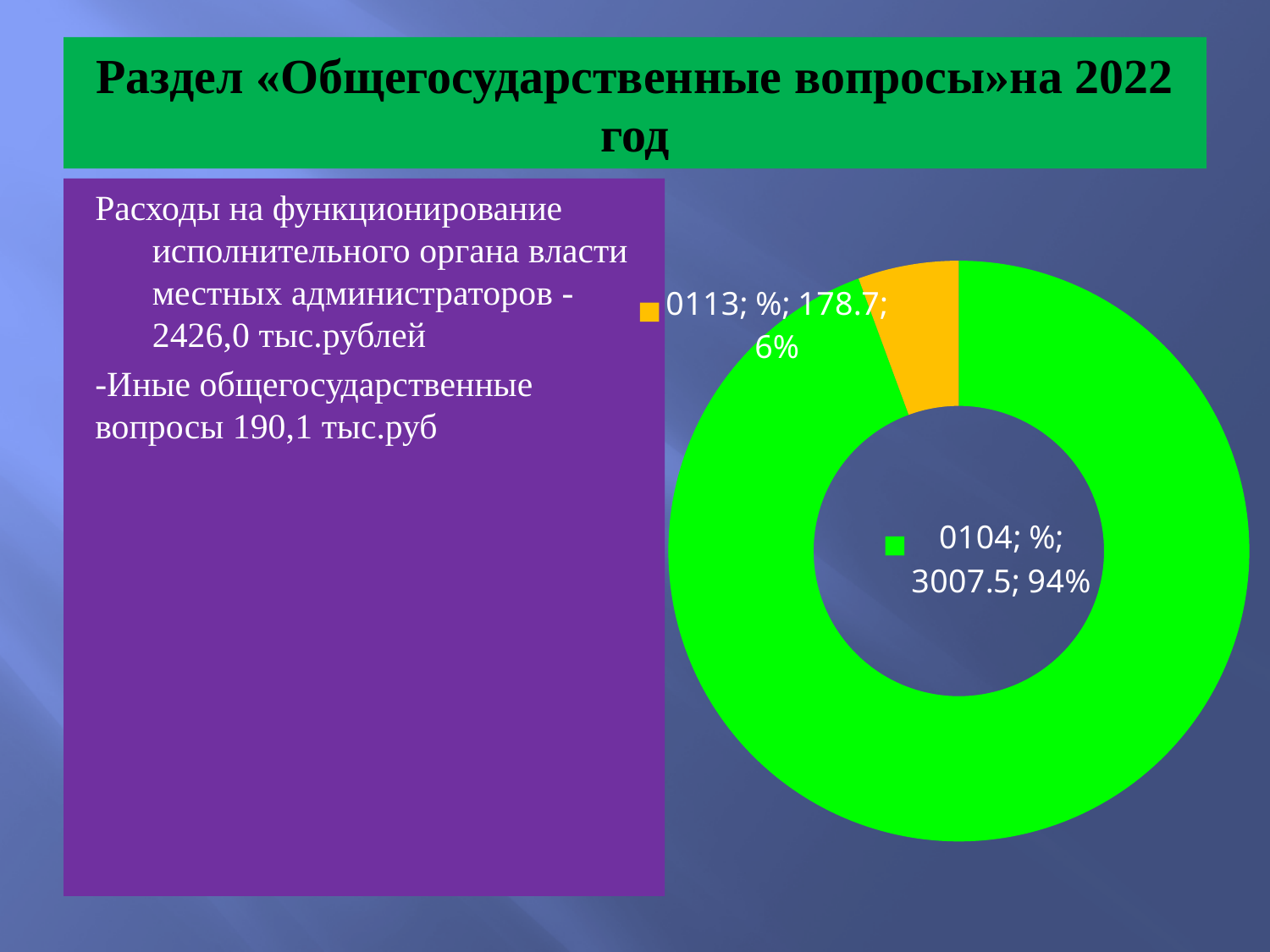
Which category has the smallest slice? 0113 What share of the doughnut does category 0104 represent? 94% What colour is the slice for category 0113? orange What colour is the slice for category 0104? green What kind of chart is shown on the slide? doughnut (pie) chart What is the value shown for category 0104? 3007.5 Which is larger, the value for 0104 or the value for 0113? 0104 How many slices does the doughnut chart have? 2 What share of the doughnut does category 0113 represent? 6% Which category has the largest slice? 0104 What is the difference between the values for 0104 and 0113? 2828.8 What is the value shown for category 0113? 178.7